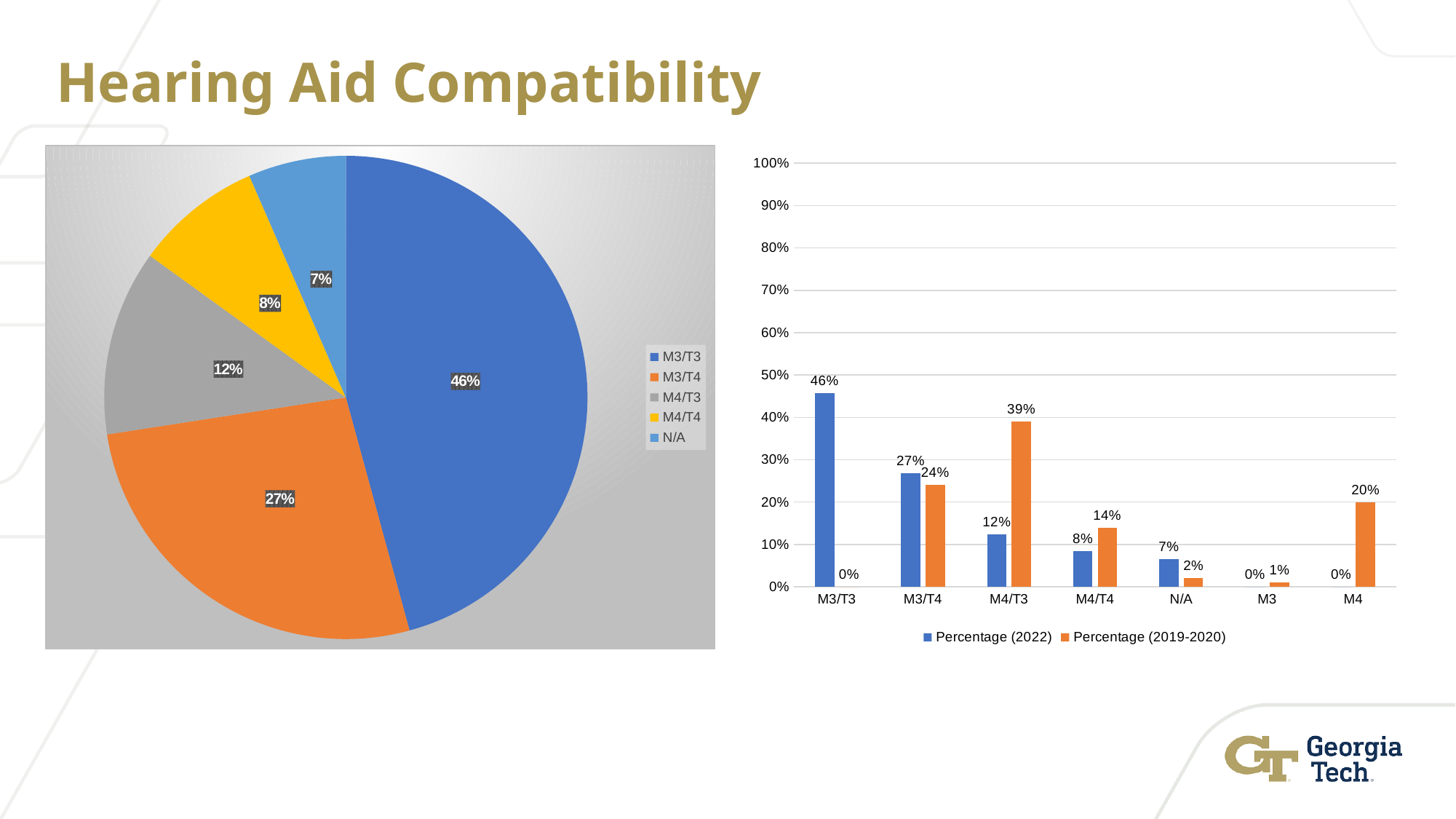
In the bar chart on the right, which category has the highest Percentage (2022) value? M3/T3 How many series does the legend of the bar chart on the right list? 2 In the bar chart on the right, which is larger for M4/T4: Percentage (2022) or Percentage (2019-2020)? Percentage (2019-2020) In the bar chart on the right, what is the Percentage (2019-2020) value for M4/T3? 39% In the bar chart on the right, what is the Percentage (2022) value for M3/T4? 27% In the pie chart on the left, what share does M3/T3 have? 46% What kind of chart is on the right side of the slide? Bar chart In the pie chart on the left, what share does M4/T3 have? 12% How many slices does the pie chart on the left have? 5 In the bar chart on the right, what is the difference between the Percentage (2019-2020) and Percentage (2022) values for M4/T3? 27% In the pie chart on the left, which category has the smallest slice? N/A How many categories are shown on the x axis of the bar chart on the right? 7